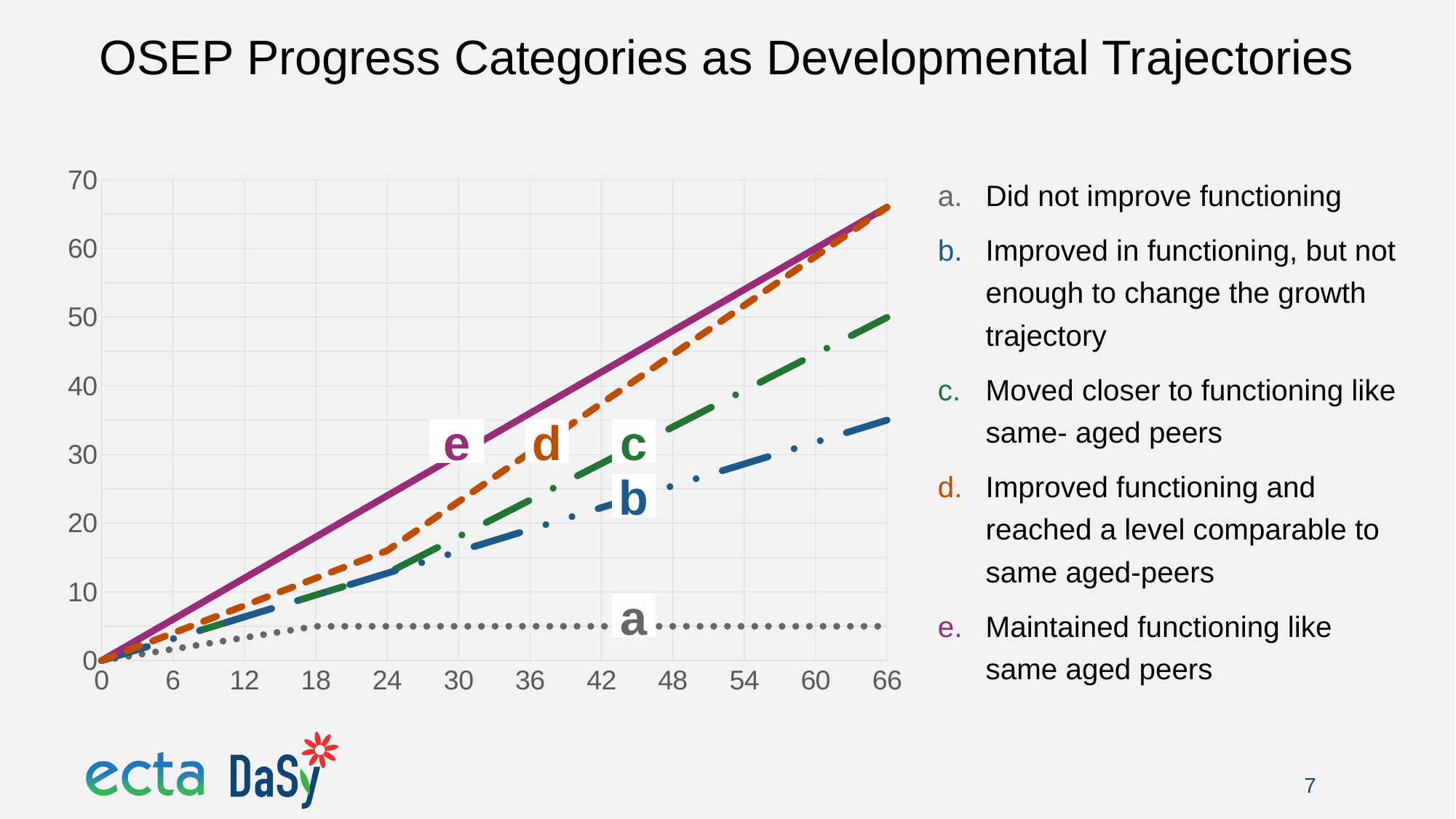
At x = 66, which line has the larger value, b or c? c What is the title of the slide's chart? OSEP Progress Categories as Developmental Trajectories Does line e rise or fall as x increases from 0 to 66? rise Which line is the lowest at x = 66? a Is the value of line b at x = 66 greater or less than 40? less Is the value of line e at x = 66 greater or less than 60? greater Is the value of line a at x = 66 greater or less than 10? less What kind of chart is shown on the slide? line chart How many lines (trajectories) are plotted on the chart? 5 Does line a rise, fall, or stay flat between x = 30 and x = 66? stay flat According to the legend text, what does trajectory a represent? Did not improve functioning